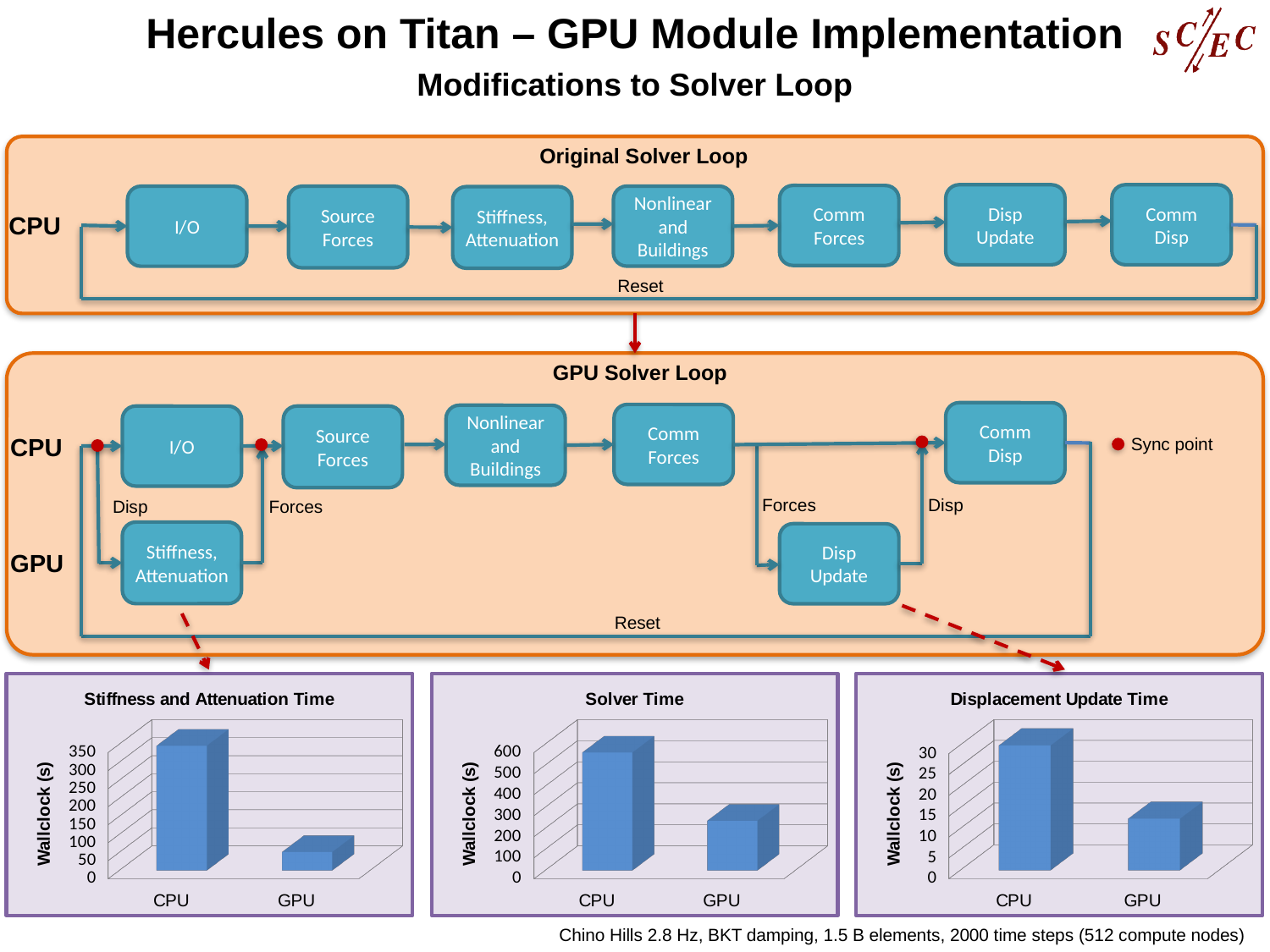
In the 'Solver Time' chart, is the value for CPU greater or less than 500? greater What is the y-axis label of the 'Stiffness and Attenuation Time' chart? Wallclock (s) In the 'Solver Time' chart, which category has the lowest value? GPU In the 'Stiffness and Attenuation Time' chart, is the value for GPU greater or less than 100? less What kind of chart is the 'Displacement Update Time' chart? bar chart In the 'Displacement Update Time' chart, is the value for CPU larger or smaller than the value for GPU? larger How many categories are shown on the x axis of the 'Solver Time' chart? 2 In the 'Solver Time' chart, is the value for GPU greater or less than 300? less In the 'Stiffness and Attenuation Time' chart, which category has the higher value? CPU